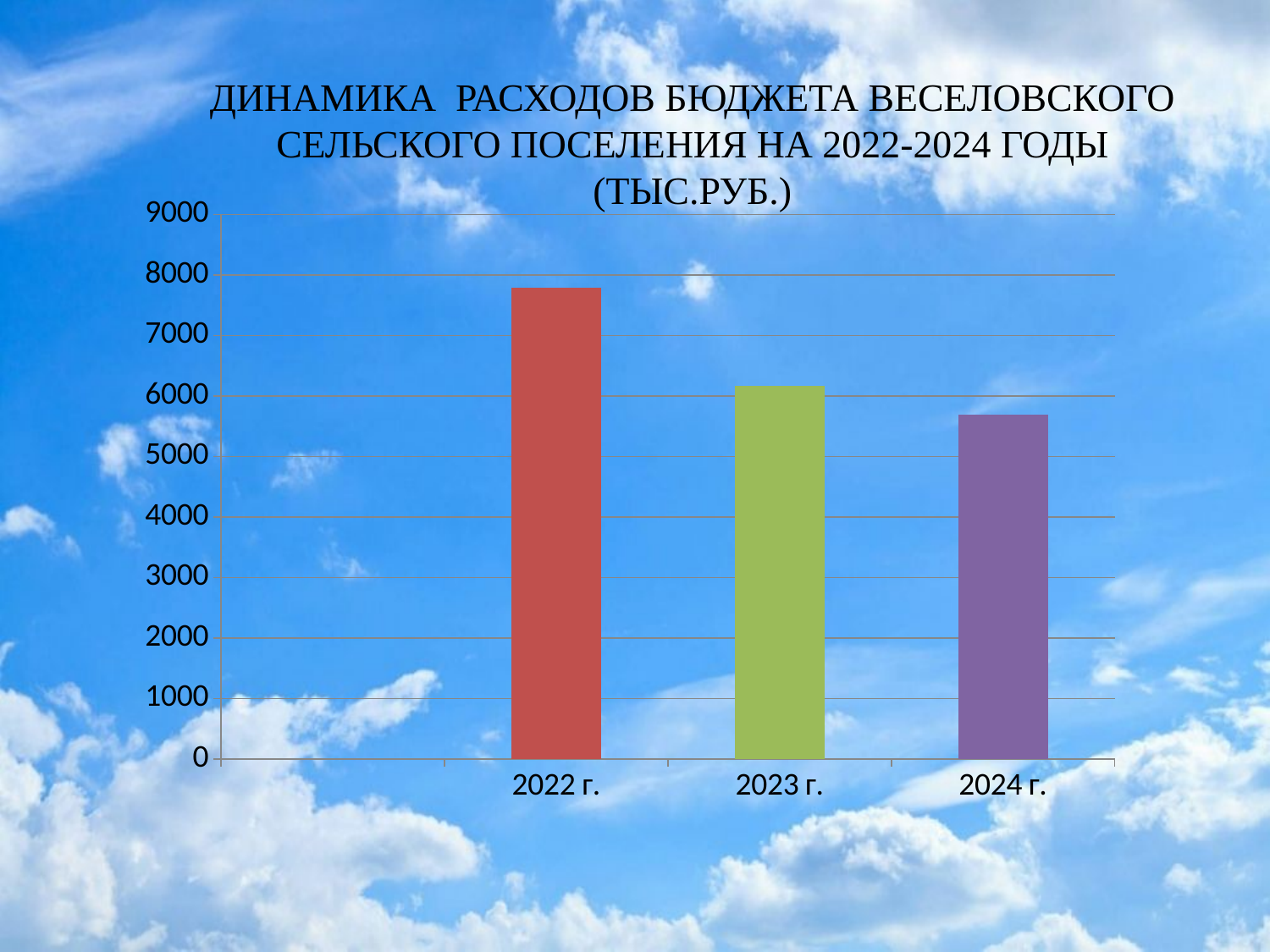
Is the value for 2024 г. greater or less than 5000? greater What kind of chart is shown on the slide? bar chart Which is larger, the value for 2022 г. or the value for 2023 г.? 2022 г. Is the value for 2024 г. greater or less than 6000? less Which is larger, the value for 2023 г. or the value for 2024 г.? 2023 г. Do the values rise or fall from 2022 г. to 2024 г.? fall Which year has the lowest budget expenditure in the chart? 2024 г. Is the value for 2023 г. greater or less than 7000? less Which year has the highest budget expenditure in the chart? 2022 г. How many bars (years) are plotted in the chart? 3 In what units are the values in the chart expressed, according to the title? тыс.руб.